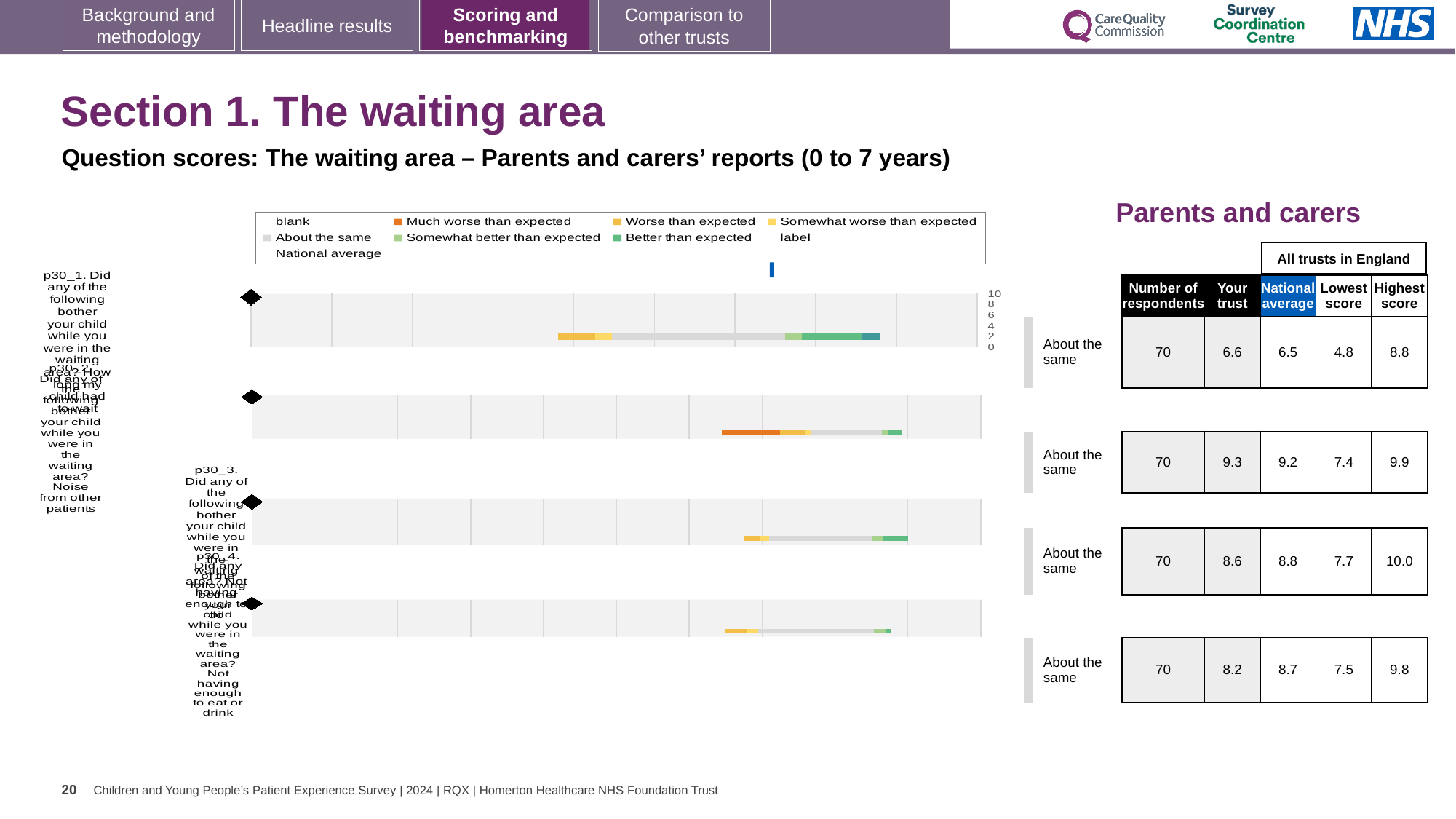
How many respondents are listed for each of the four questions? 70 What is the lowest score across all trusts in England for the fourth question (p30_4)? 7.5 What is the difference between the 'Your trust' score and the national average for the fourth question (p30_4)? 0.5 How many question bars are plotted in the chart? 4 What is the highest score across all trusts in England for the third question (p30_3)? 10.0 In the chart legend, what colour represents 'About the same'? grey Which question has the highest 'Your trust' score? p30_2 Which question has the lowest 'Your trust' score? p30_1 What is the national average for the second question (p30_2) in the table? 9.2 What is the 'Your trust' score for the first question (p30_1) in the table? 6.6 In the chart legend, what colour represents 'Much worse than expected'? orange What kind of chart is shown on the slide? bar chart